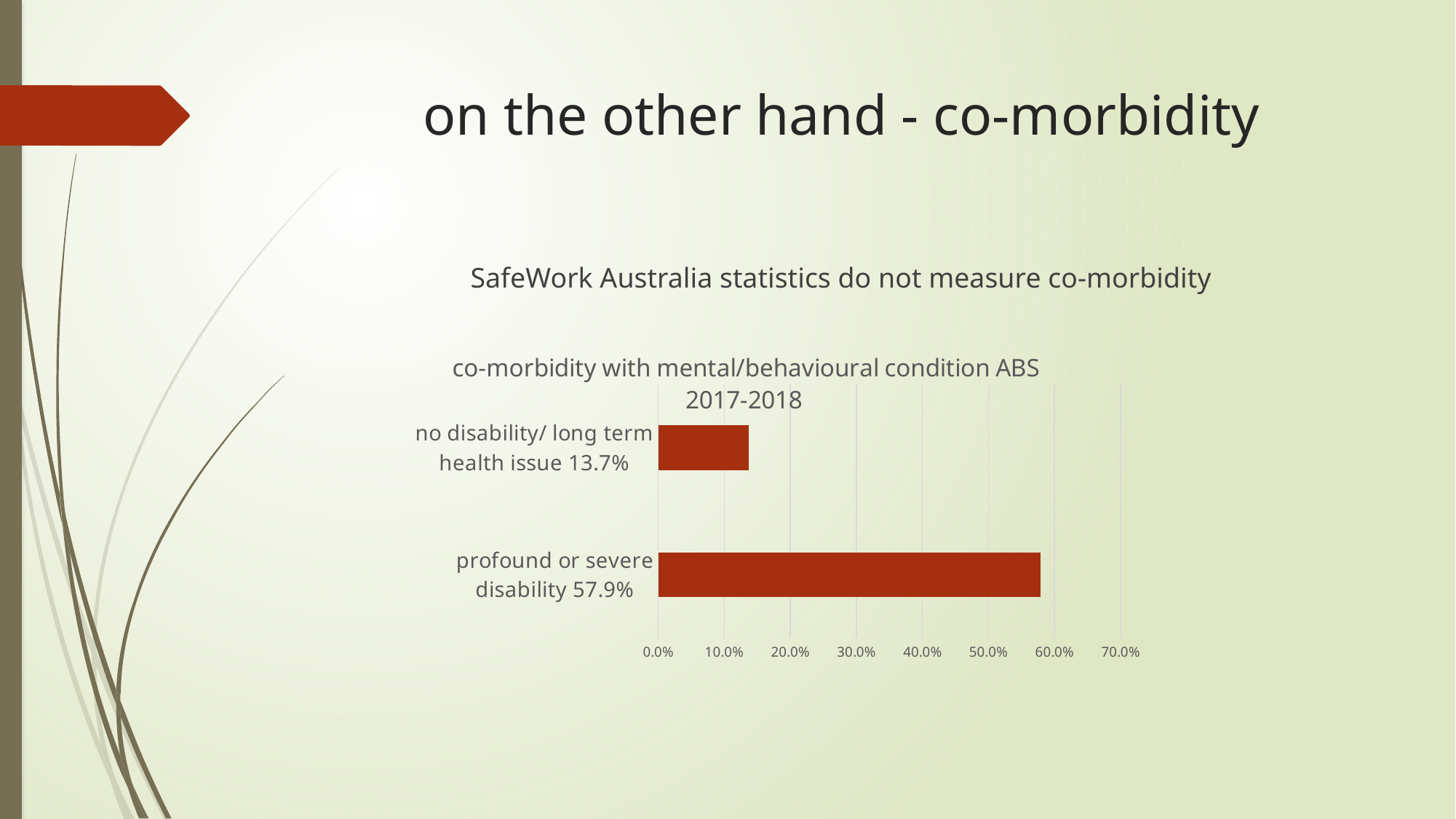
Which category has the highest value? profound or severe disability Which is larger, the value for profound or severe disability or the value for no disability/ long term health issue? profound or severe disability What type of chart is shown on the slide? bar chart What is the title of the chart? co-morbidity with mental/behavioural condition ABS 2017-2018 Which category has the lowest value? no disability/ long term health issue What is the difference between the value for profound or severe disability and the value for no disability/ long term health issue? 44.2% What is the value for profound or severe disability? 57.9% How many categories are plotted in the chart? 2 What is the value for no disability/ long term health issue? 13.7% Is the value for profound or severe disability greater or less than 50.0%? greater Is the value for no disability/ long term health issue greater or less than 20.0%? less What is the highest value shown on the x axis of the chart? 70.0%